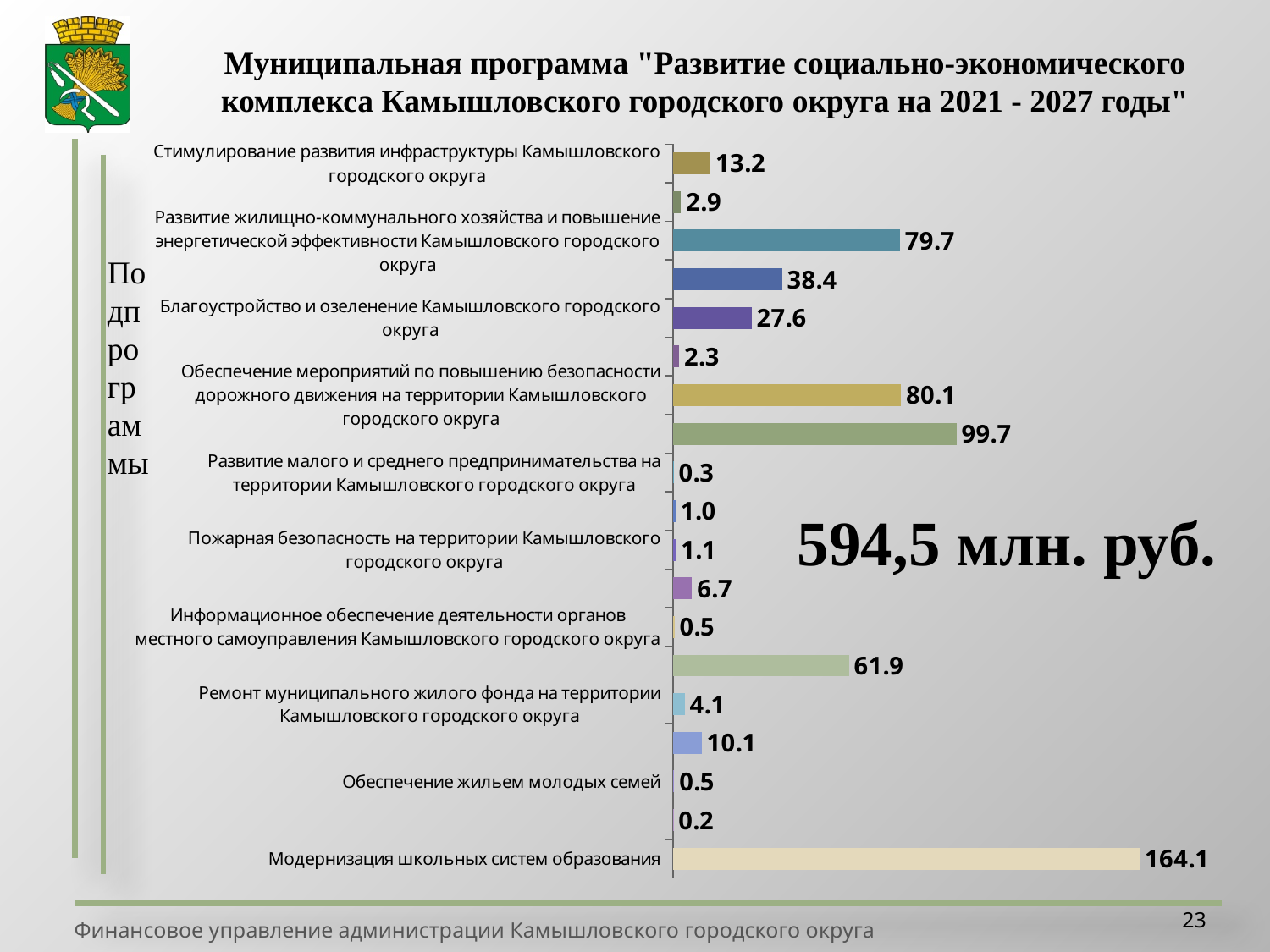
What total amount is printed in large text next to the chart? 594,5 млн. руб. What is the value for "Ремонт муниципального жилого фонда на территории Камышловского городского округа"? 4.1 What is the value for "Благоустройство и озеленение Камышловского городского округа"? 27.6 What is the value for "Пожарная безопасность на территории Камышловского городского округа"? 1.1 What is the value for "Модернизация школьных систем образования"? 164.1 How many bars are plotted in the chart? 19 Which is larger: the value for "Благоустройство и озеленение Камышловского городского округа" or the value for "Стимулирование развития инфраструктуры Камышловского городского округа"? Благоустройство и озеленение Камышловского городского округа What type of chart is shown on the slide? bar chart What is the value for "Стимулирование развития инфраструктуры Камышловского городского округа"? 13.2 What is the difference between the value for "Модернизация школьных систем образования" and the value for "Обеспечение мероприятий по повышению безопасности дорожного движения на территории Камышловского городского округа"? 84.0 Which category has the highest value in the chart? Модернизация школьных систем образования What is the smallest value labelled on any bar in the chart? 0.2